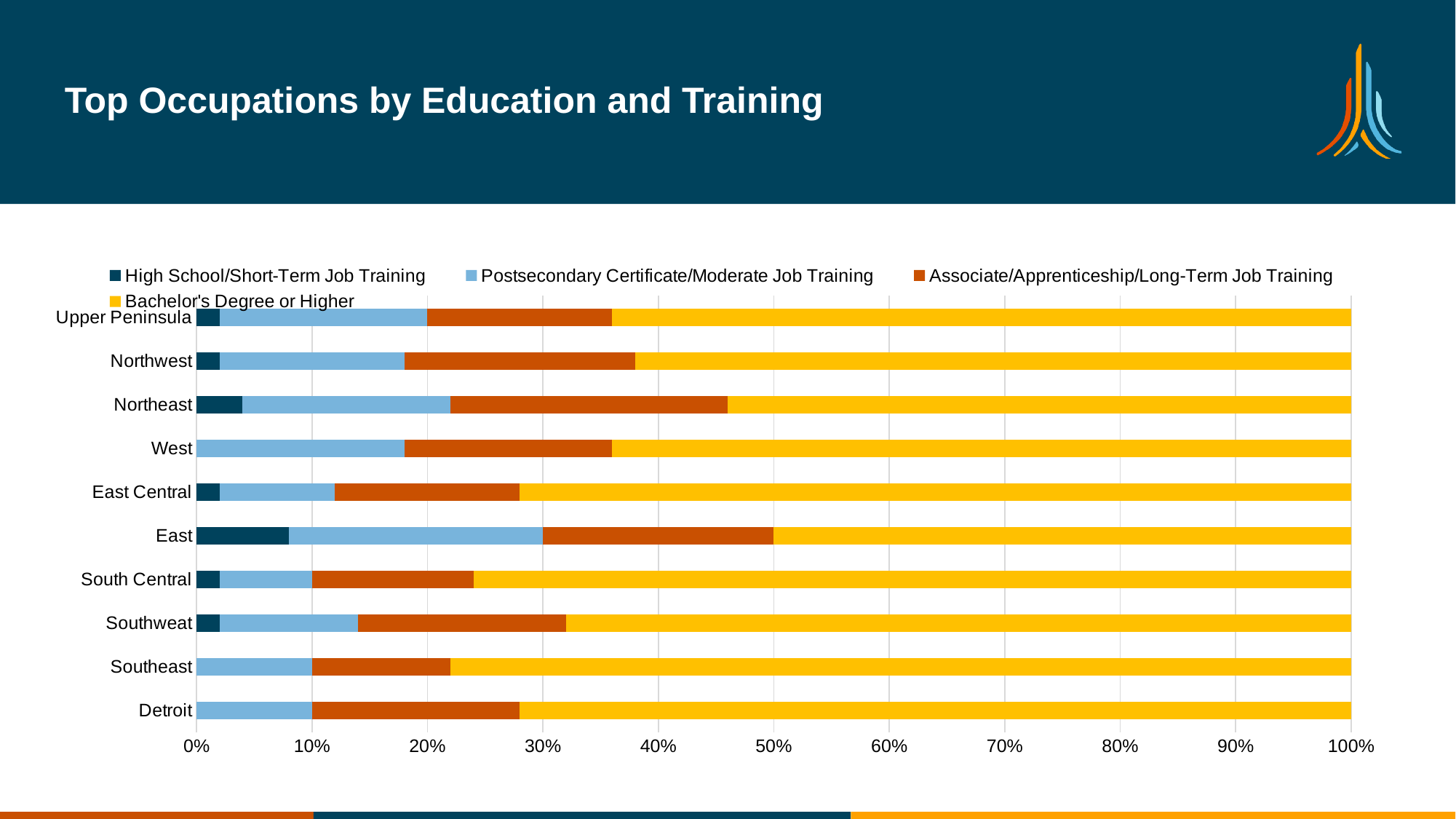
Which series is shown in yellow? Bachelor's Degree or Higher Which has the larger Bachelor's Degree or Higher share, Southeast or East? Southeast What is the title of the slide? Top Occupations by Education and Training Which region has the largest High School/Short-Term Job Training share? East Is the Associate/Apprenticeship/Long-Term Job Training share for East Central greater or less than 10%? greater Is the High School/Short-Term Job Training share for East greater or less than 10%? less How many regions are plotted on the chart? 10 Is the Postsecondary Certificate/Moderate Job Training share for Northeast greater or less than 10%? greater Which has the larger High School/Short-Term Job Training share, East or Northeast? East How many series does the legend list? 4 What kind of chart is shown on the slide? bar chart